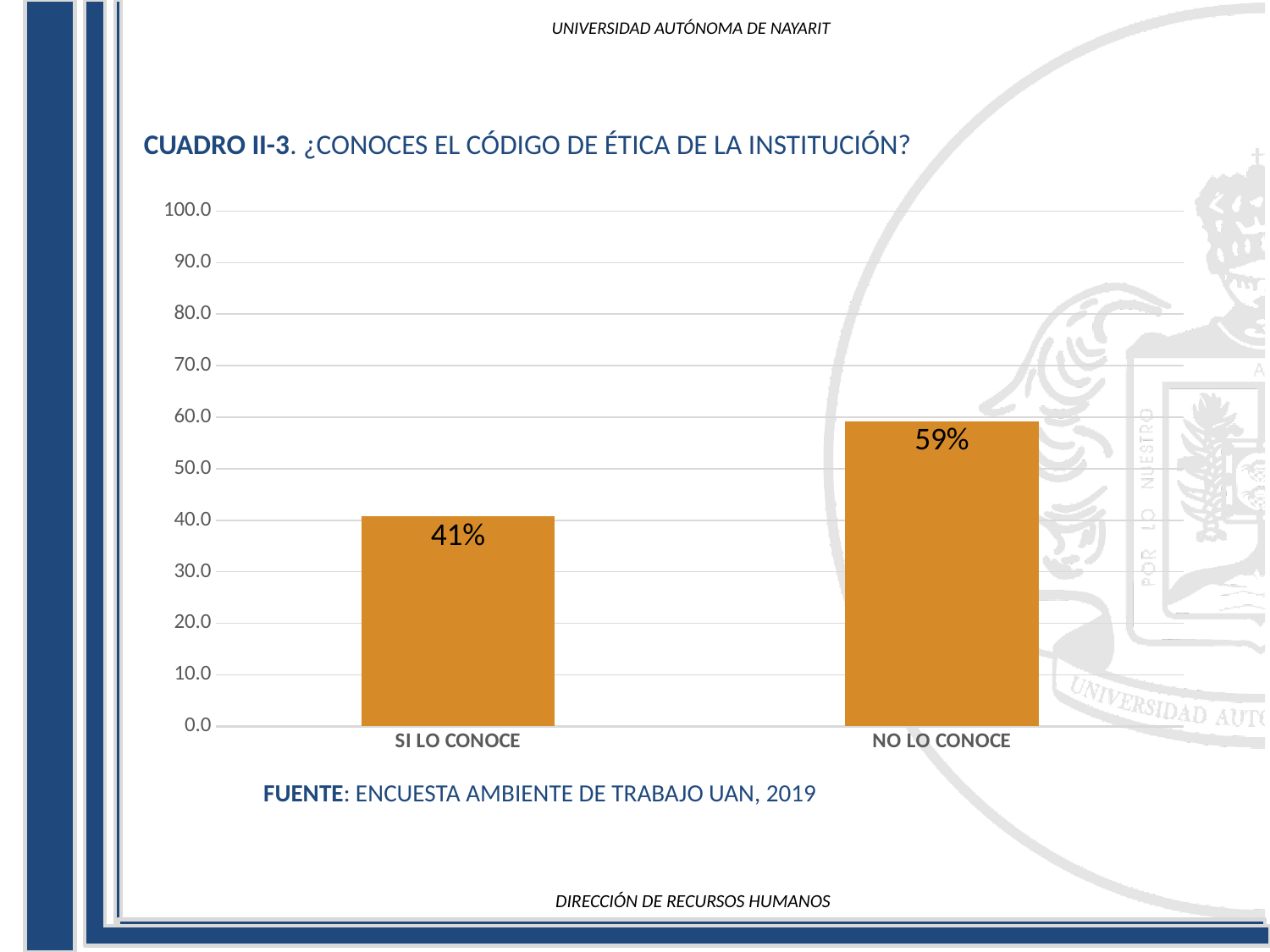
How many categories are shown on the x axis? 2 What is the difference between the values for NO LO CONOCE and SI LO CONOCE? 18% What is the maximum value shown on the y axis? 100.0 What kind of chart is shown on the slide? bar chart Is the value for NO LO CONOCE greater or less than 50.0? greater Which category has the highest value? NO LO CONOCE Which is larger, the value for SI LO CONOCE or the value for NO LO CONOCE? NO LO CONOCE What is the value for SI LO CONOCE? 41% Is the value for SI LO CONOCE greater or less than 50.0? less What is the value for NO LO CONOCE? 59% What is the title of the chart? CUADRO II-3. ¿CONOCES EL CÓDIGO DE ÉTICA DE LA INSTITUCIÓN? Which category has the lowest value? SI LO CONOCE